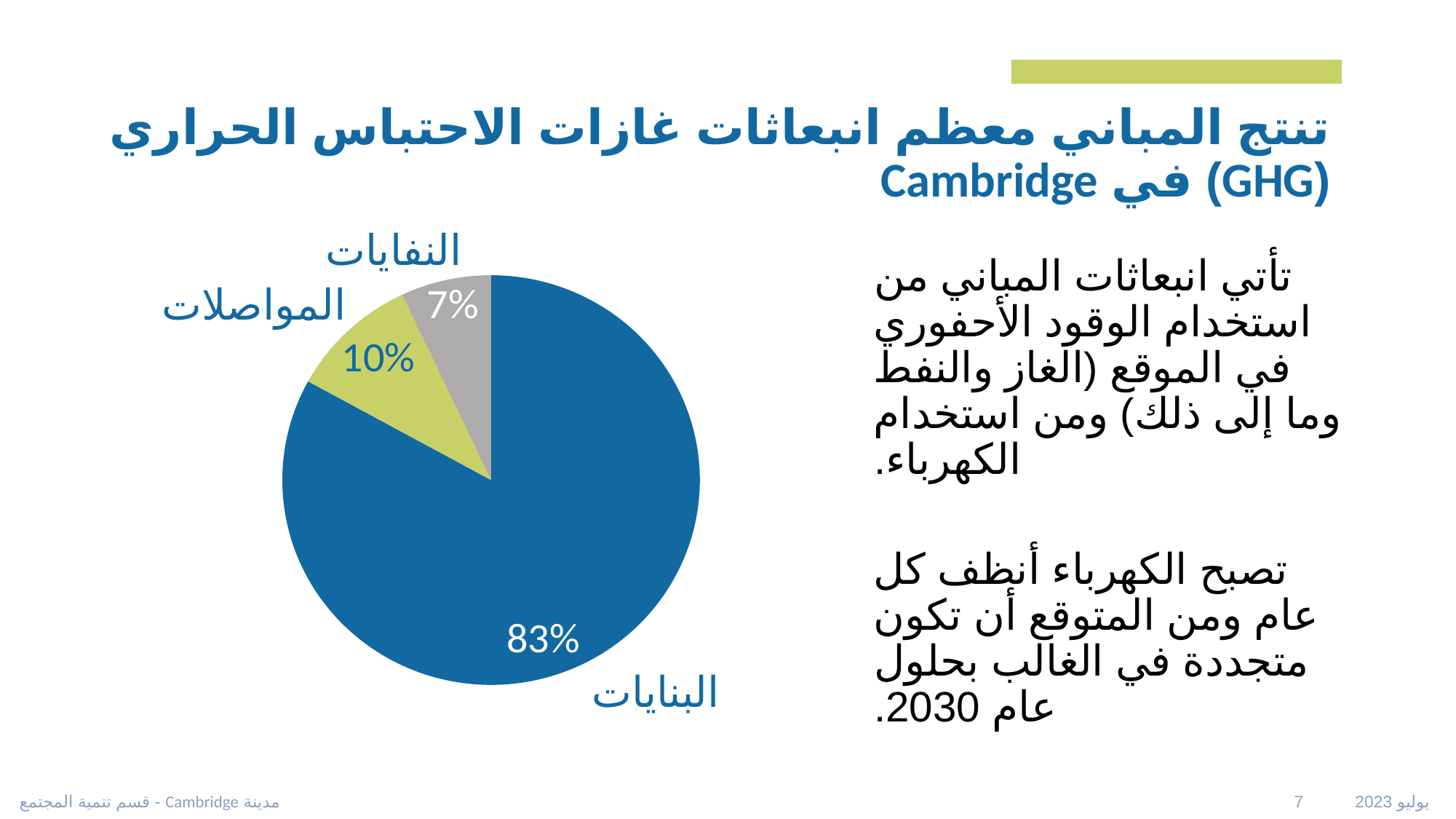
What share of the pie does البنايات (buildings) account for? 83% How many slices does the pie chart have? 3 What is the difference in percentage points between the البنايات slice and the المواصلات slice? 73 What share of the pie does المواصلات (transportation) account for? 10% What colour is the slice for البنايات? Blue What is the difference in percentage points between the المواصلات slice and the النفايات slice? 3 Which category has the smallest slice of the pie? النفايات What share of the pie does النفايات (waste) account for? 7% Which is larger, the slice for المواصلات or the slice for النفايات? المواصلات What kind of chart is shown on the slide? Pie chart What colour is the slice for النفايات? Grey Which category has the largest slice of the pie? البنايات